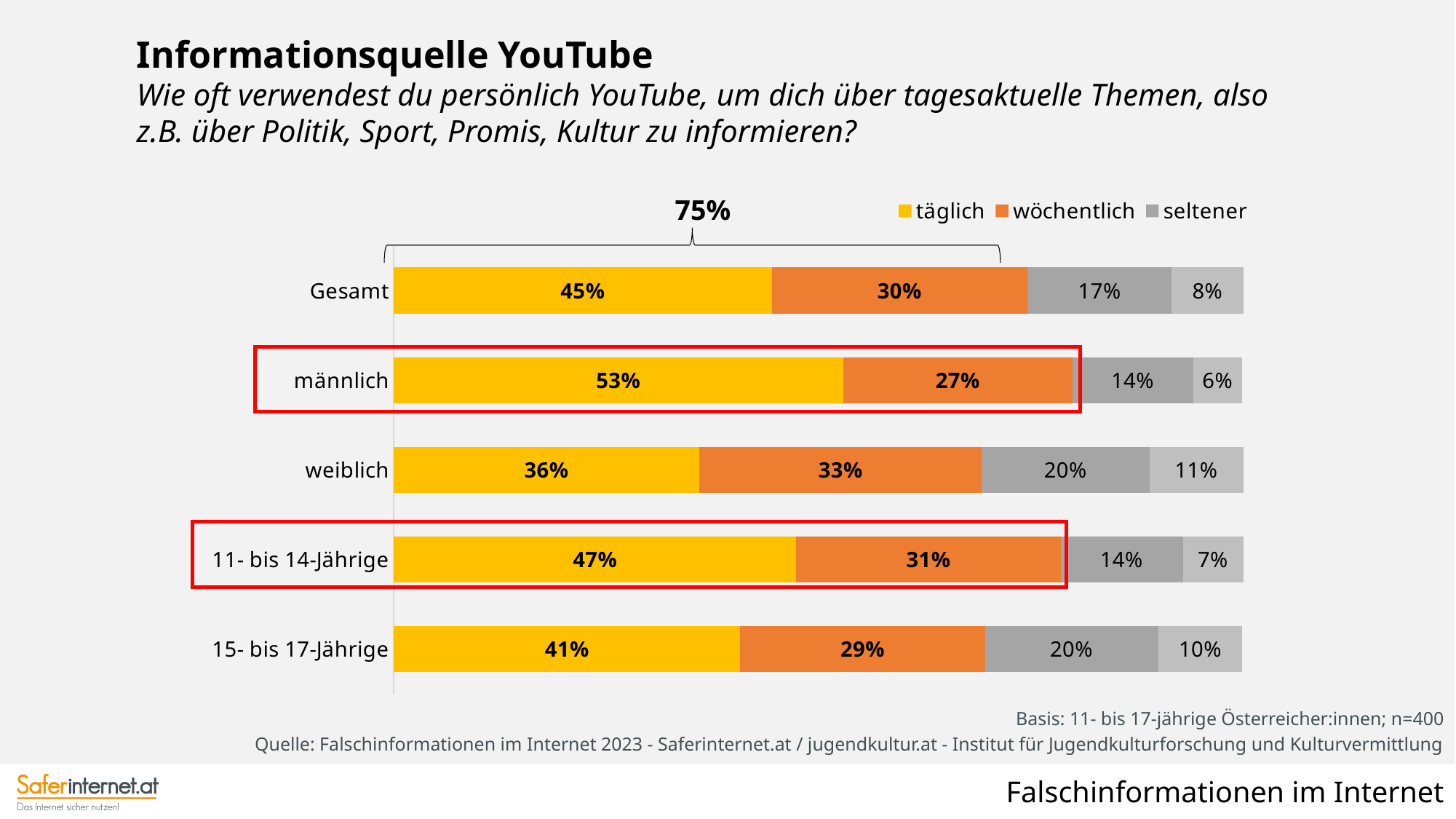
What is the title of the slide? Informationsquelle YouTube What is the difference between the 'täglich' values for 'männlich' and 'weiblich'? 17% What is the combined 'täglich' and 'wöchentlich' share for 'Gesamt'? 75% How many series does the legend list? 3 What is the 'täglich' value for 'Gesamt'? 45% What is the 'wöchentlich' value for 'weiblich'? 33% What is the 'seltener' value for '15- bis 17-Jährige'? 20% What type of chart is shown on the slide? stacked bar chart Which is larger, the 'wöchentlich' value for '11- bis 14-Jährige' or for '15- bis 17-Jährige'? 11- bis 14-Jährige Which category has the highest 'täglich' value? männlich How many categories are shown on the y axis of the chart? 5 Which category has the lowest 'täglich' value? weiblich